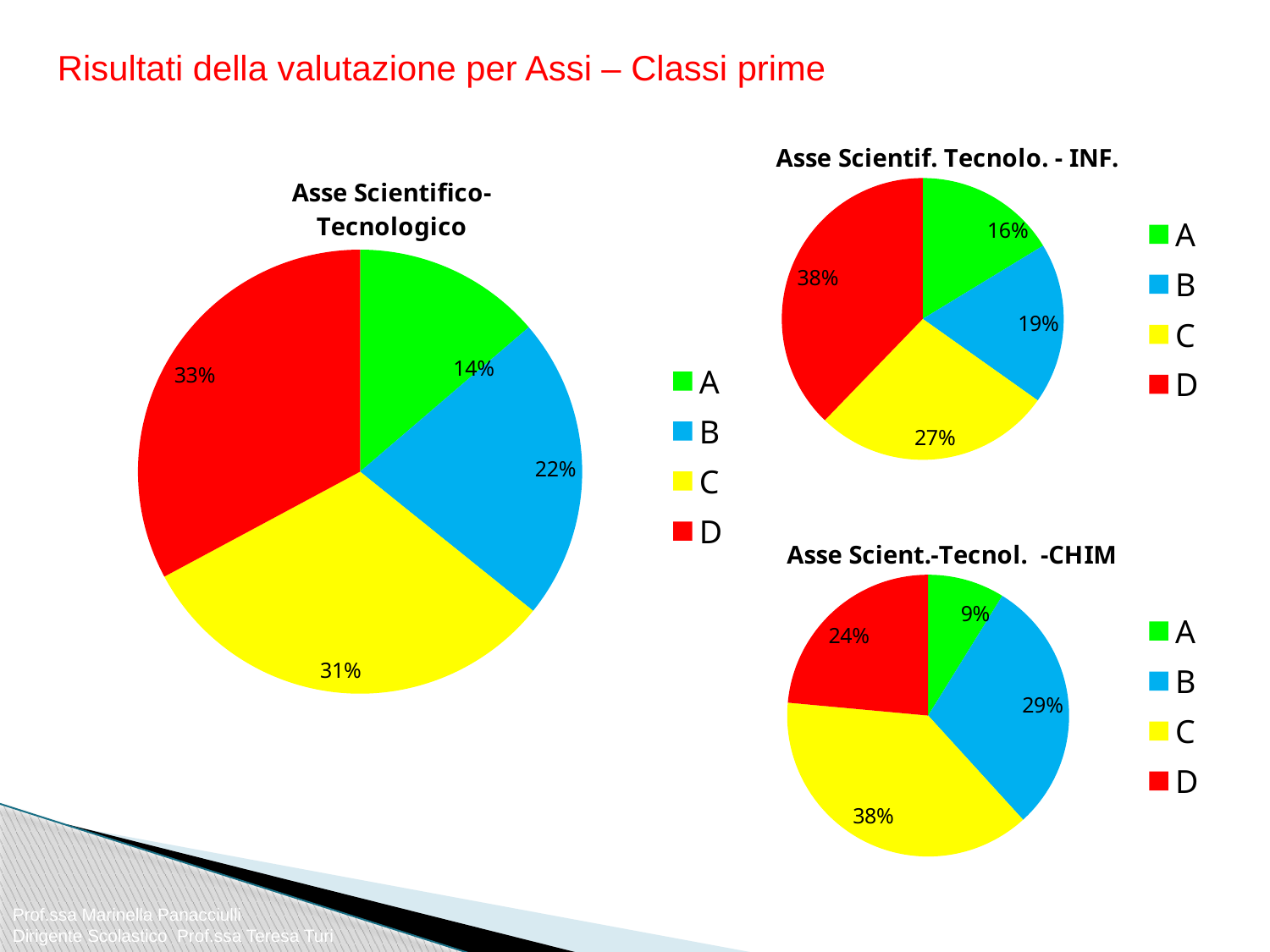
In the "Asse Scientif. Tecnolo. - INF." chart, what colour represents category C in the legend? Yellow What type of chart is "Asse Scient.-Tecnol. -CHIM"? Pie chart In the "Asse Scientifico-Tecnologico" pie chart, what is the difference between the shares of C and B? 9% In the "Asse Scient.-Tecnol. -CHIM" pie chart, what is the difference between the shares of B and D? 5% How many slices does the "Asse Scientifico-Tecnologico" pie chart have? 4 In the "Asse Scient.-Tecnol. -CHIM" pie chart, what share does category A have? 9% In the "Asse Scientif. Tecnolo. - INF." pie chart, which category has the largest share? D In the "Asse Scient.-Tecnol. -CHIM" pie chart, which category has the largest share? C In the "Asse Scientif. Tecnolo. - INF." pie chart, what share does category D have? 38% In the "Asse Scientifico-Tecnologico" pie chart, what share does category D have? 33% In the "Asse Scientif. Tecnolo. - INF." pie chart, which is larger, the share of B or the share of C? C In the "Asse Scientifico-Tecnologico" pie chart, which category has the smallest share? A